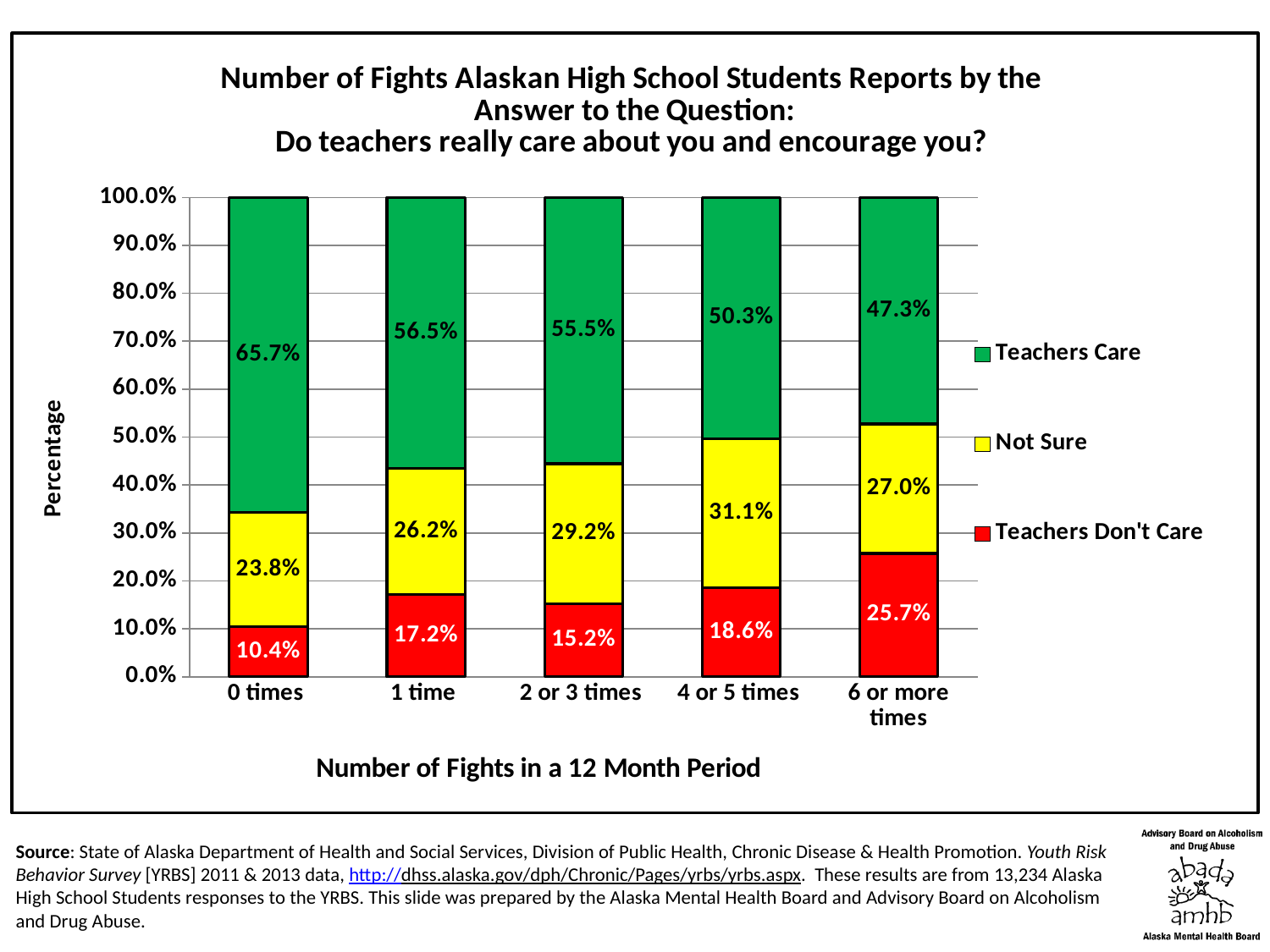
Which colour represents the 'Not Sure' series? Yellow What is the 'Teachers Don't Care' value for students reporting 6 or more fights? 25.7% Which category has the highest 'Teachers Care' percentage? 0 times Which category has the lowest 'Teachers Don't Care' percentage? 0 times What kind of chart is shown on the slide? Stacked bar chart What is the 'Not Sure' value for the '4 or 5 times' category? 31.1% Is the 'Not Sure' value larger for '1 time' or for '2 or 3 times'? 2 or 3 times How does the 'Teachers Care' percentage change as the number of fights increases along the x axis? It falls What percentage of students who reported 0 fights said teachers care? 65.7% How many series does the legend list? 3 How many categories are shown on the x axis? 5 What is the difference between the 'Teachers Care' values for '0 times' and '6 or more times'? 18.4%